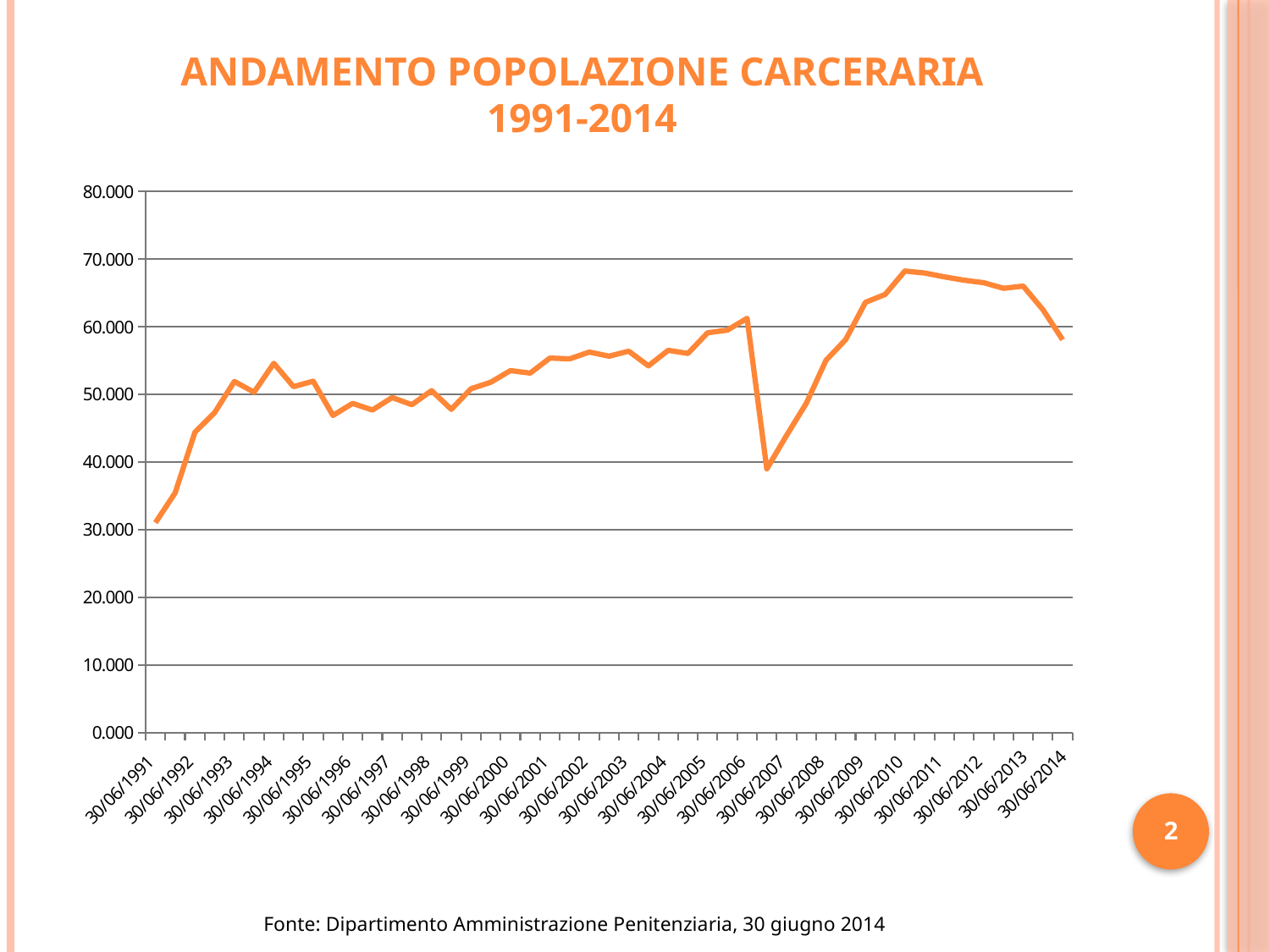
Which is larger, the value for 30/06/1991 or the value for 30/06/2014? 30/06/2014 Which date on the x axis has the lowest value on the line? 30/06/1991 What is the title of the chart on the slide? ANDAMENTO POPOLAZIONE CARCERARIA 1991-2014 Which is larger, the value for 30/06/2006 or the value for 30/06/2007? 30/06/2006 Does the line rise or fall between 30/06/2010 and 30/06/2014? Falls Is the value for 30/06/1996 greater or less than 50.000? less Is the value for 30/06/1991 greater or less than 40.000? less What kind of chart is shown on the slide? Line chart Is the value for 30/06/2010 greater or less than 60.000? greater What source is cited below the chart? Dipartimento Amministrazione Penitenziaria, 30 giugno 2014